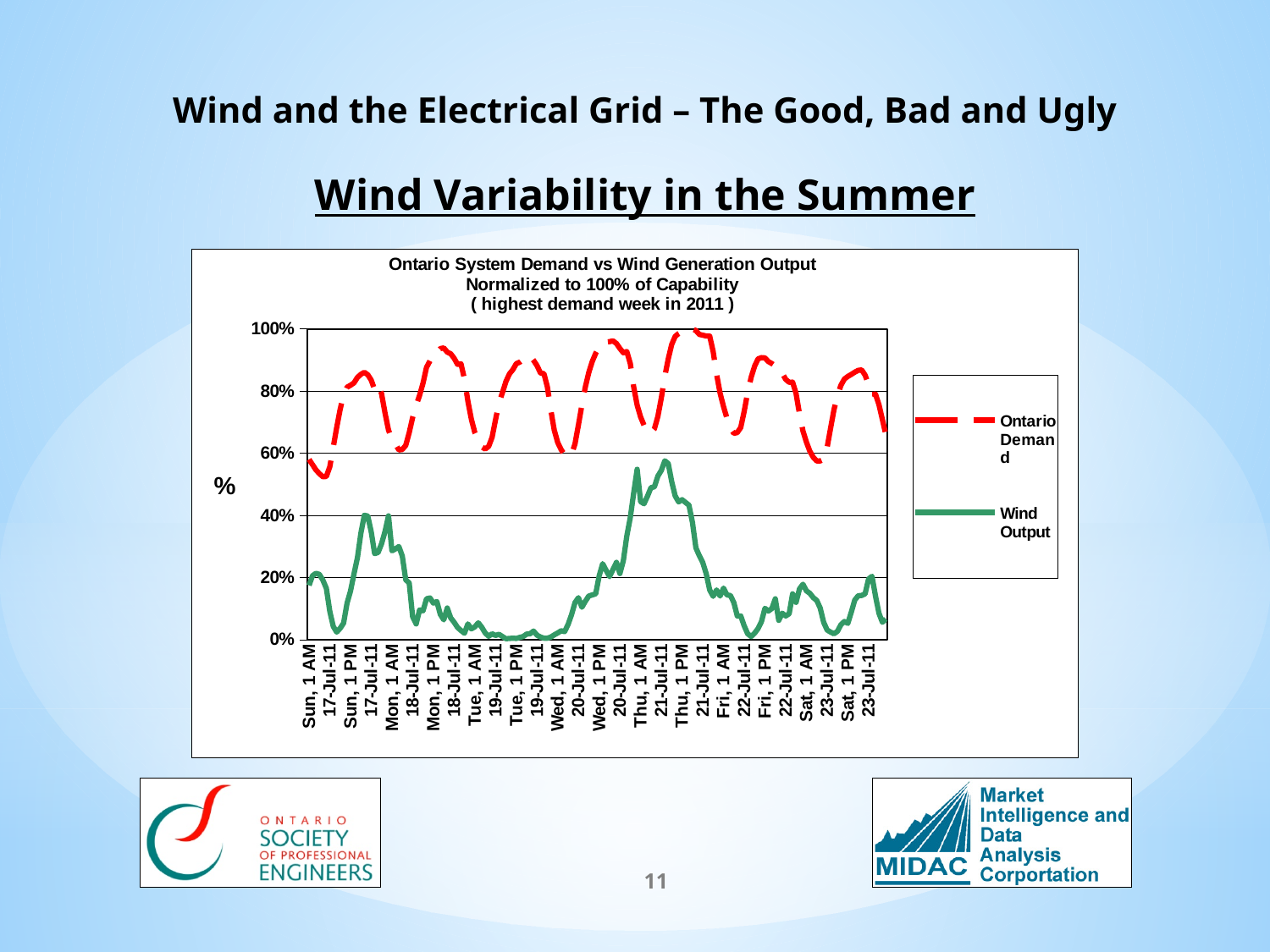
At Wed, 1 AM, which series has the larger value, Ontario Demand or Wind Output? Ontario Demand Is the Ontario Demand value at Thu, 1 PM greater or less than 80%? greater What is the highest value shown on the chart's vertical axis? 100% Is the peak Wind Output value around 21-Jul-11 greater or less than 40%? greater Which series reaches the higher values on the chart, Ontario Demand or Wind Output? Ontario Demand What kind of chart is shown on the slide? Line chart Is the Wind Output value at Tue, 1 PM greater or less than 20%? less How many series does the chart's legend list? 2 What are the two series named in the chart's legend? Ontario Demand and Wind Output Which series is drawn as a red dashed line? Ontario Demand